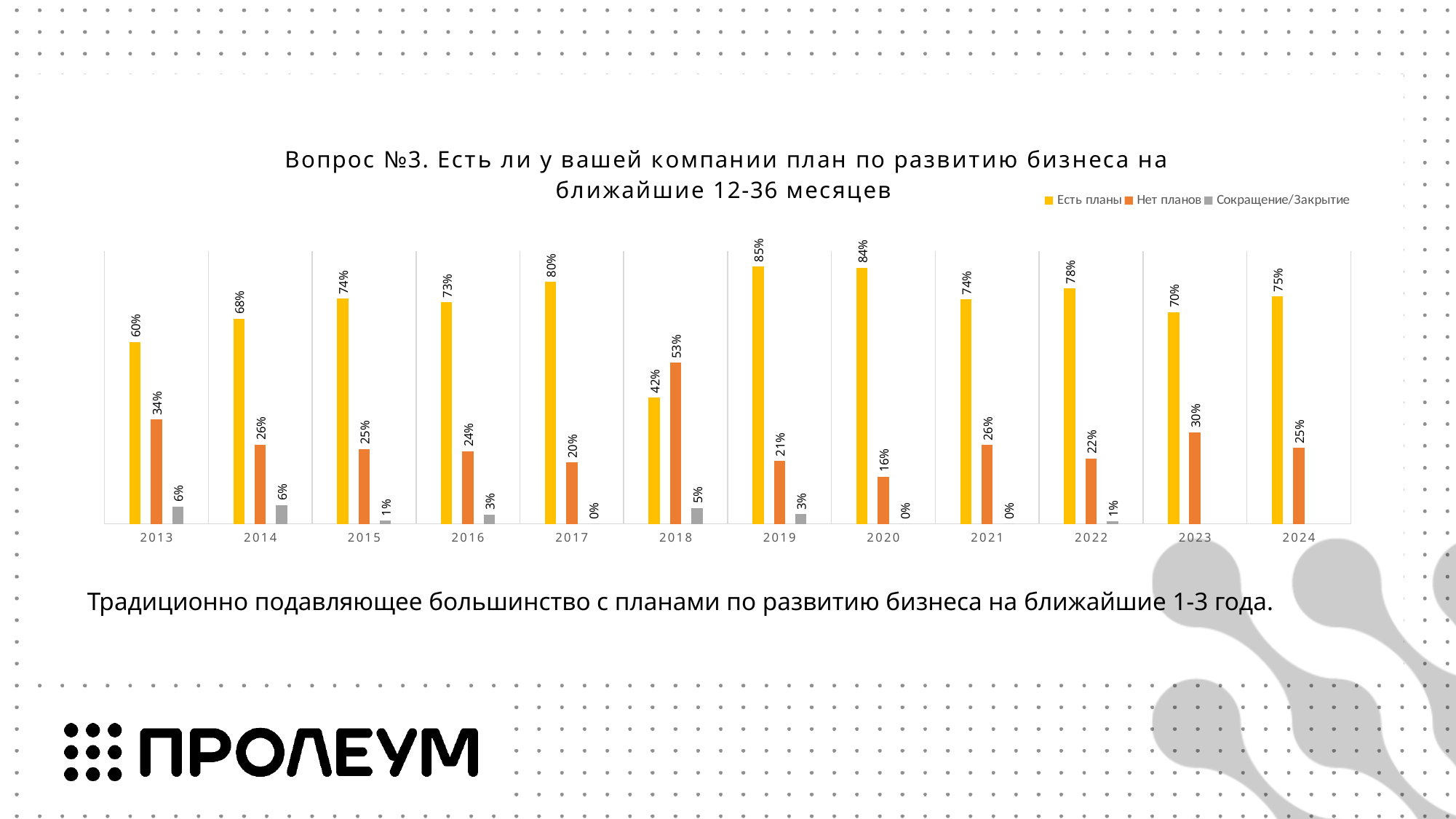
What is the value for Нет планов in 2018? 53% Which series is shown in yellow in the legend? Есть планы What type of chart is shown on the slide? bar chart What is the value for Сокращение/Закрытие in 2014? 6% How many series does the legend list? 3 How many years are shown on the x axis? 12 What is the value for Есть планы in 2013? 60% In which year is the value for Нет планов the lowest? 2020 Which is larger in 2018, Есть планы or Нет планов? Нет планов In which year is the value for Есть планы the lowest? 2018 In which year is the value for Есть планы the highest? 2019 What is the difference between Есть планы and Нет планов in 2024? 50%